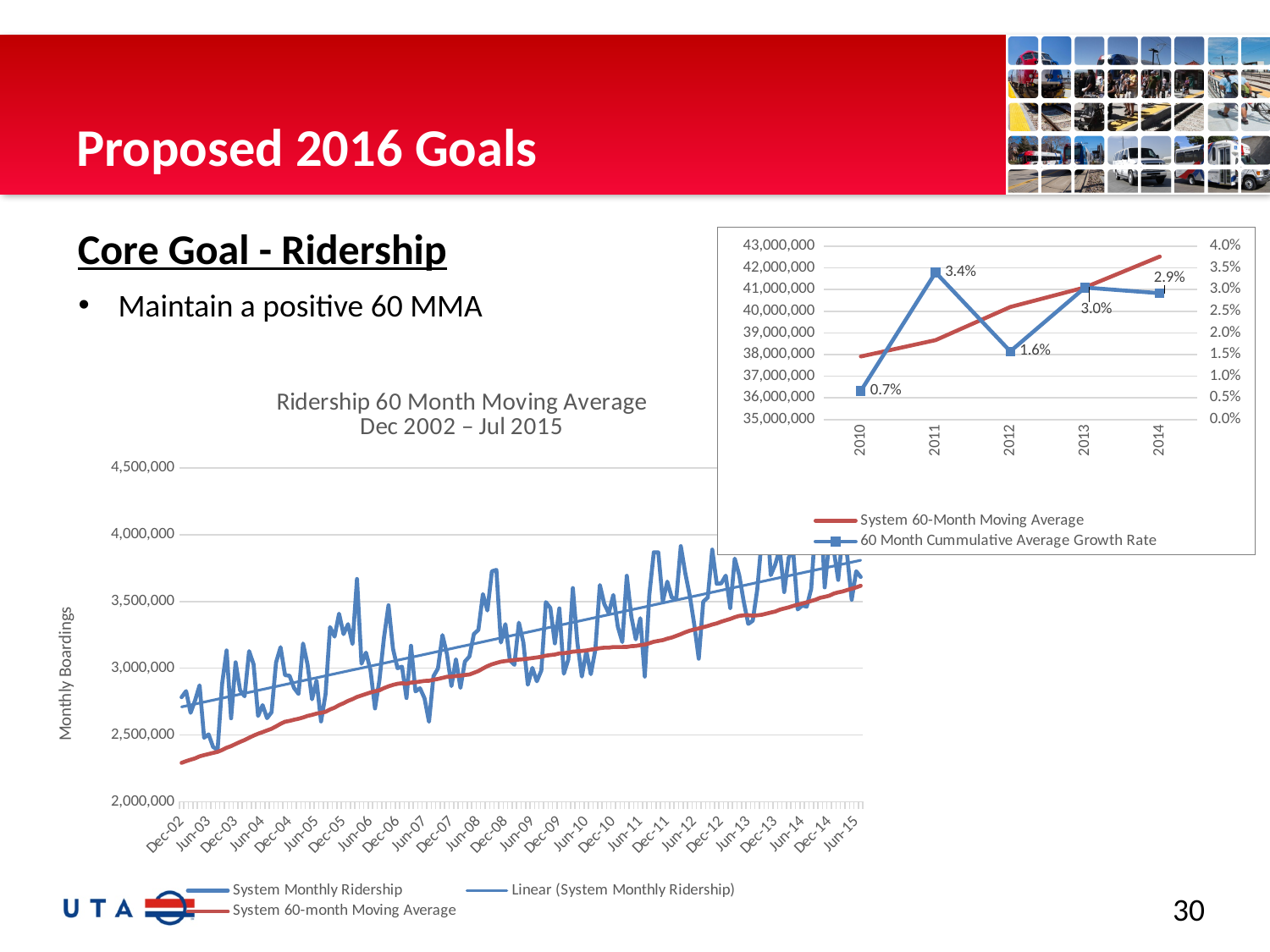
In the top-right chart, which year has the lowest 60 Month Cummulative Average Growth Rate? 2010 In the top-right chart, how many series does the legend list? 2 In the top-right chart, is the growth rate higher in 2013 or in 2014? 2013 In the top-right chart, which year has the highest 60 Month Cummulative Average Growth Rate? 2011 In the top-right chart, what is the 60 Month Cummulative Average Growth Rate for 2011? 3.4% In the top-right chart, does the System 60-Month Moving Average rise or fall from 2010 to 2014? rise In the top-right chart, how many years are shown on the x axis? 5 In the top-right chart, what is the 60 Month Cummulative Average Growth Rate for 2010? 0.7% In the 'Ridership 60 Month Moving Average' chart, is the System 60-month Moving Average at Dec-02 greater or less than 2,500,000? less What kind of chart is the 'Ridership 60 Month Moving Average Dec 2002 – Jul 2015' chart? line chart In the top-right chart, what is the difference between the growth rate in 2011 and the growth rate in 2012? 1.8% In the 'Ridership 60 Month Moving Average' chart, what is the label on the vertical axis? Monthly Boardings